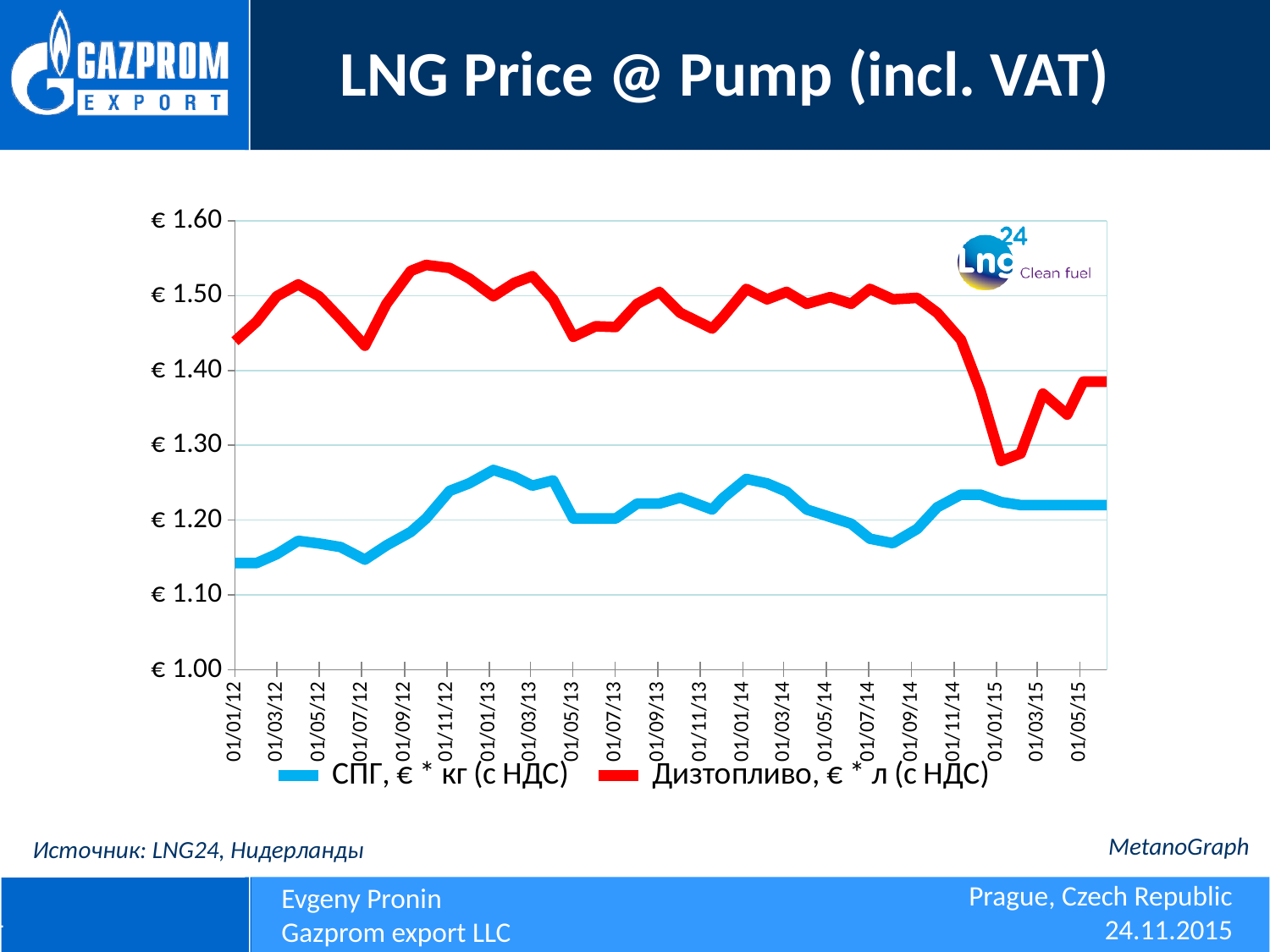
Is the value for Дизтопливо, € * л (с НДС) at 01/01/15 greater or less than € 1.40? less Is the value for Дизтопливо, € * л (с НДС) at 01/11/12 greater or less than € 1.50? greater Which series has the higher value at 01/01/14, СПГ, € * кг (с НДС) or Дизтопливо, € * л (с НДС)? Дизтопливо, € * л (с НДС) Is the value for СПГ, € * кг (с НДС) at 01/01/13 greater or less than € 1.20? greater How many series does the legend list? 2 Does the Дизтопливо, € * л (с НДС) series rise or fall between 01/09/14 and 01/01/15? fall What is the title of the slide's chart? LNG Price @ Pump (incl. VAT) Does the СПГ, € * кг (с НДС) series rise or fall between 01/07/12 and 01/01/13? rise What kind of chart is shown on the slide? line chart Which colour is used for the Дизтопливо, € * л (с НДС) series? red